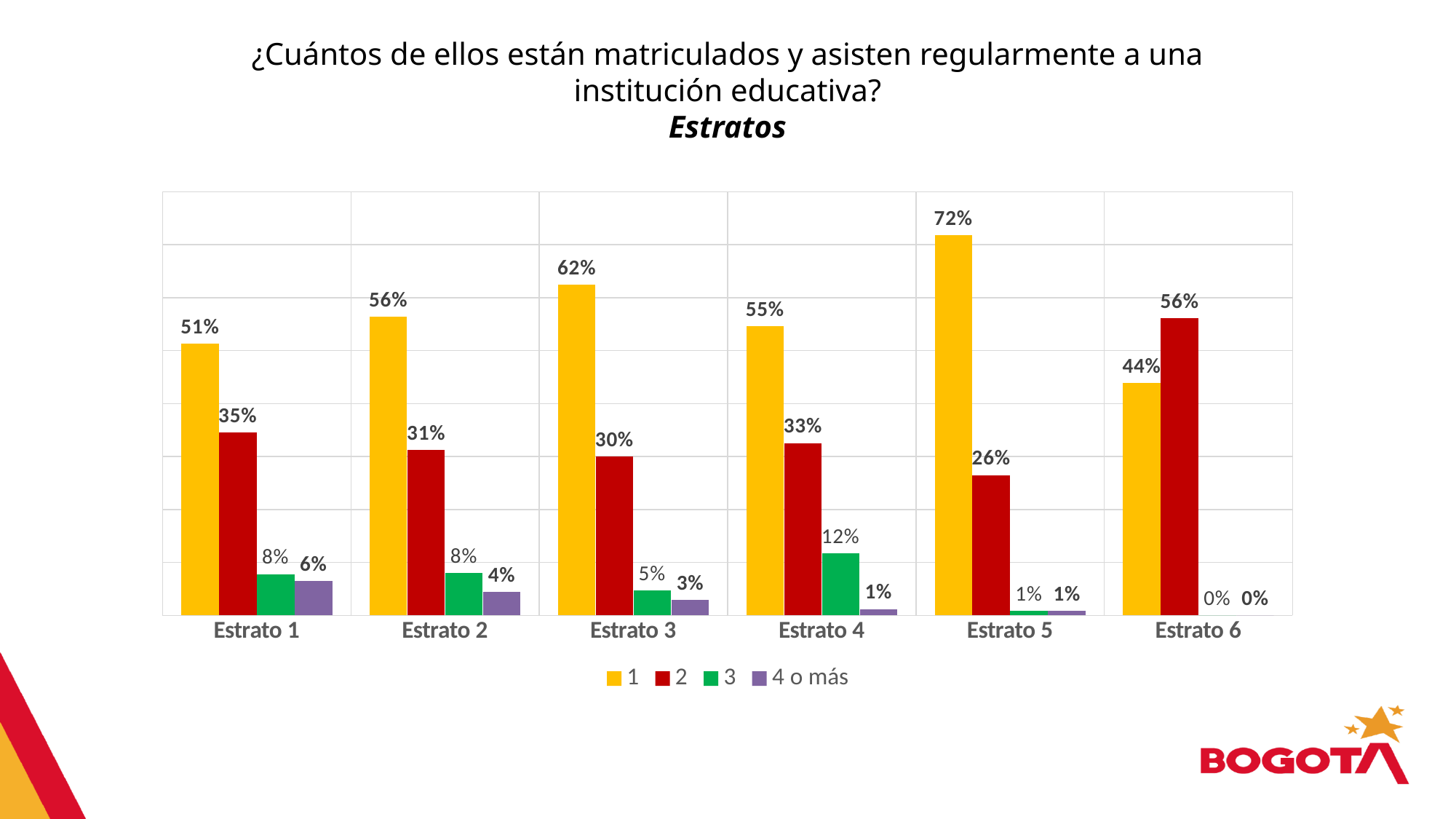
What is the value for series '4 o más' in Estrato 1? 6% In Estrato 6, which is larger: series 1 or series 2? 2 Which Estrato has the lowest value for series 1? Estrato 6 What is the difference between series 1 and series 2 in Estrato 3? 32% How many series does the legend list? 4 What is the value for series 3 in Estrato 4? 12% What is the value for series 2 in Estrato 6? 56% What kind of chart is shown on the slide? Bar chart What is the value for series 1 in Estrato 5? 72% What colour represents series 2 in the legend? Red How many Estrato categories are shown on the x axis? 6 Which Estrato has the highest value for series 1? Estrato 5